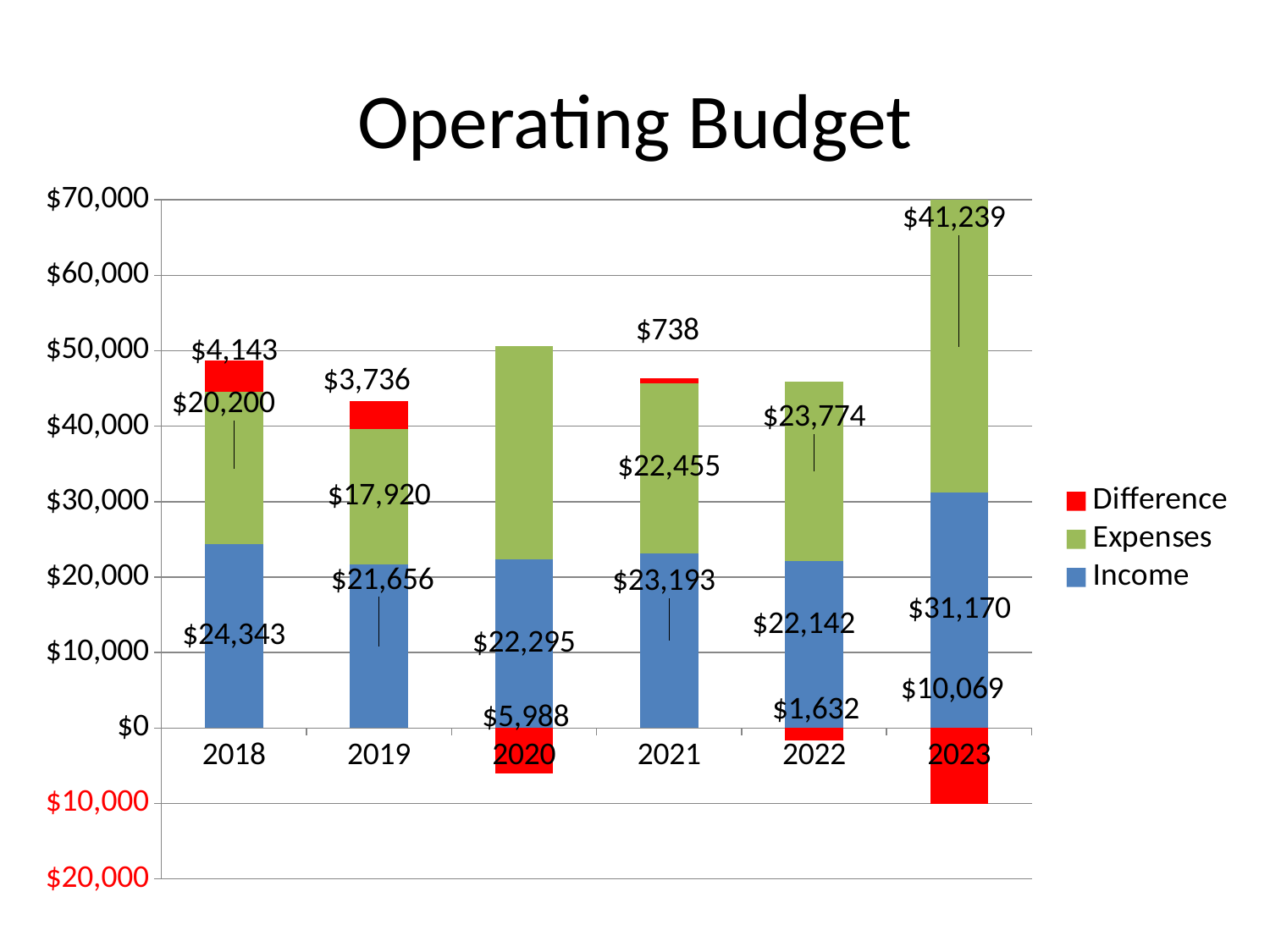
Which year has the lowest Income? 2019 What is the Difference value for 2021? $738 What is the Income value for 2018? $24,343 Is the Expenses value for 2020 greater or less than $20,000? greater How many series does the legend list? 3 How many years are shown on the x axis? 6 How much larger is the Income for 2023 than the Income for 2018? $6,827 Which year has the highest Income? 2023 What colour represents the Expenses series in the legend? Green For 2022, which is larger, Income or Expenses? Expenses What is the Expenses value for 2023? $41,239 What kind of chart is shown on the slide? Stacked bar chart